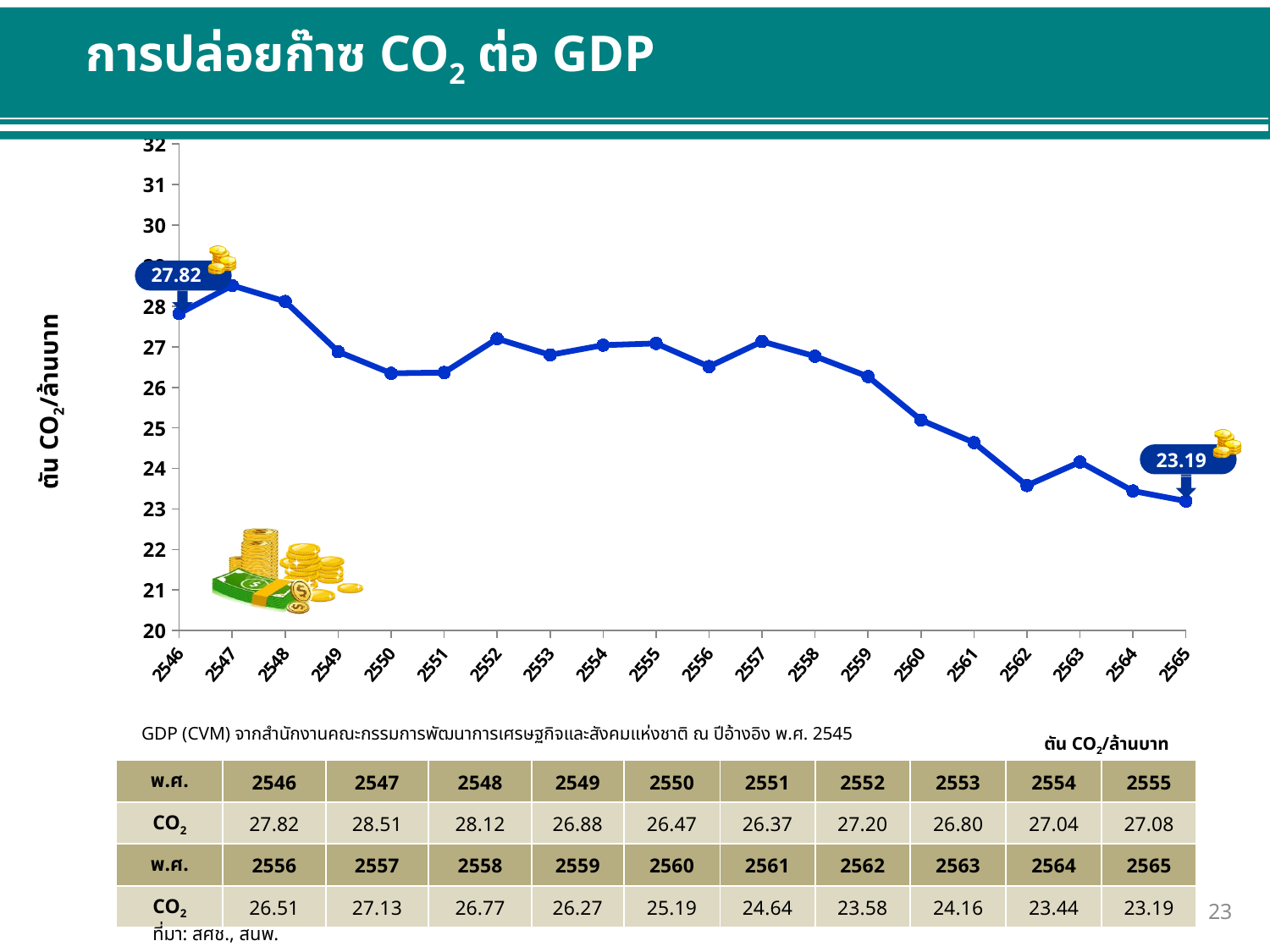
How many years (data points) are plotted on the chart? 20 Do the values generally rise or fall from 2546 to 2565? fall What is the value for 2561 according to the table below the chart? 24.64 What is the label on the vertical axis of the chart? ตัน CO2/ล้านบาท What is the value for 2565 on the chart? 23.19 What is the value for 2546 on the chart? 27.82 Is the value for 2560 greater or less than 26? less Which year has the lowest value on the chart? 2565 Which is larger, the value for 2552 or the value for 2553? 2552 What is the difference between the values for 2546 and 2565? 4.63 Which year has the highest value on the chart? 2547 What kind of chart is shown on the slide? line chart